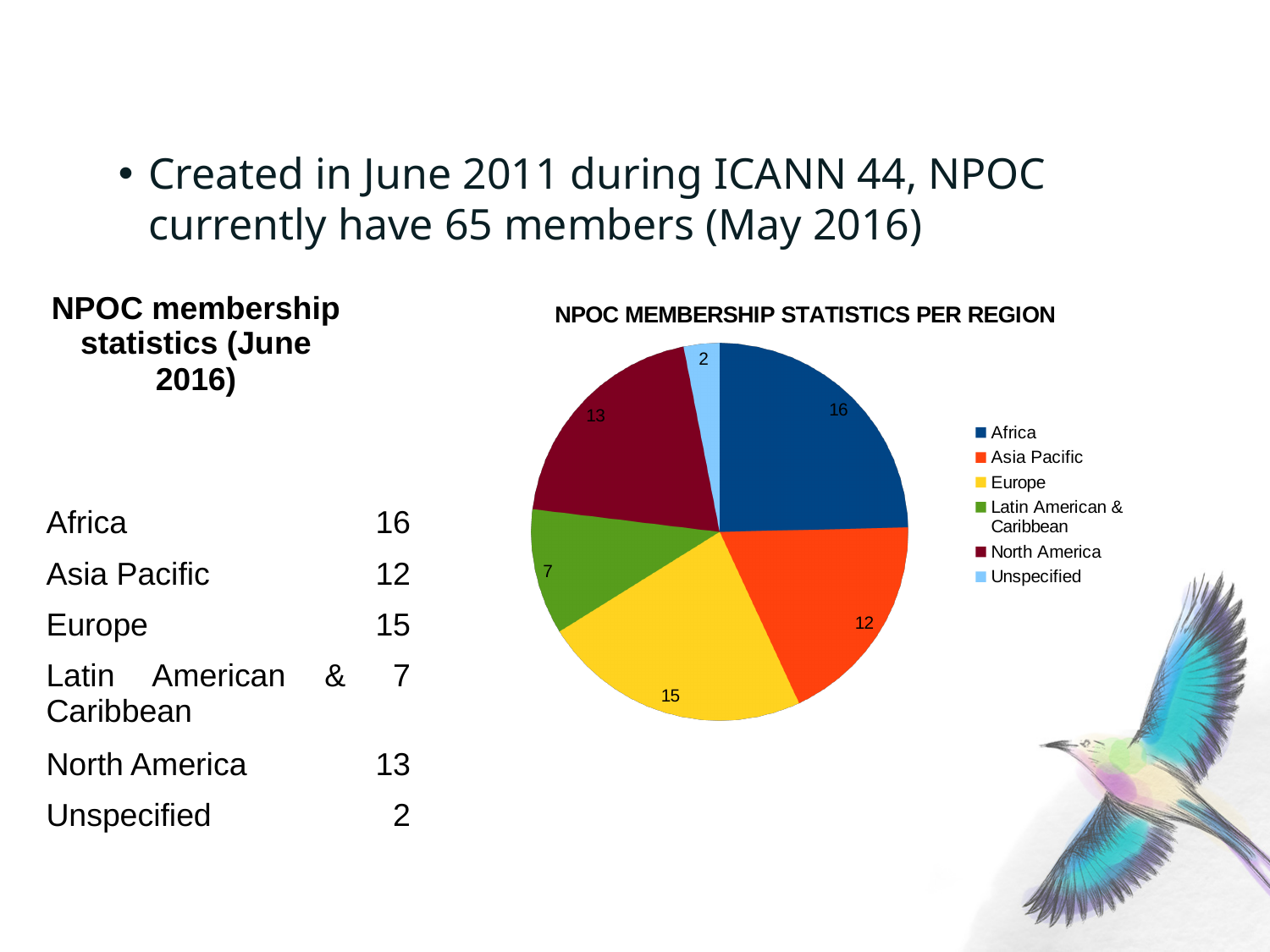
What is the value for North America in the pie chart? 13 Which region has the largest slice in the pie chart? Africa What is the value for Africa in the pie chart? 16 Which region has the smallest slice in the pie chart? Unspecified What is the value for Latin American & Caribbean in the pie chart? 7 Which is larger, the value for Europe or the value for North America? Europe What is the total of all slices in the pie chart? 65 What is the title of the chart? NPOC MEMBERSHIP STATISTICS PER REGION How many slices does the pie chart have? 6 How many entries does the chart legend list? 6 What kind of chart is shown on the slide? pie chart What is the difference between the values for Africa and Asia Pacific? 4